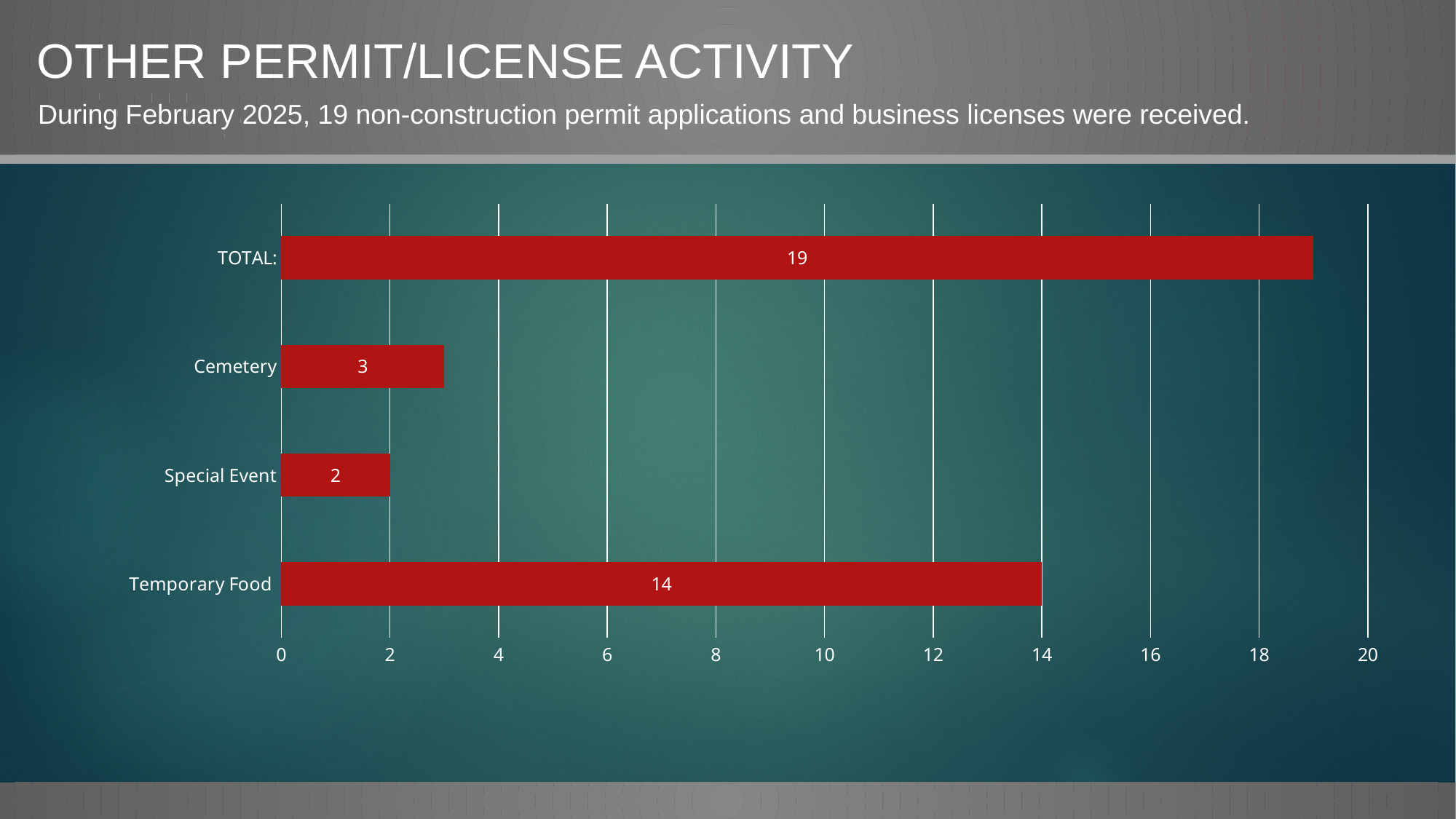
What is the difference between the values for Temporary Food and Cemetery? 11 What is the value for Cemetery? 3 Which category has the lowest value? Special Event What is the value for Temporary Food? 14 Is the value for Temporary Food greater or less than 10? greater What kind of chart is shown on the slide? bar chart What is the value shown for the TOTAL: bar? 19 Excluding the TOTAL: bar, which category has the highest value? Temporary Food What is the value for Special Event? 2 How many bars are plotted in the chart? 4 Which is larger, the value for Cemetery or the value for Special Event? Cemetery What is the title of the slide containing the chart? OTHER PERMIT/LICENSE ACTIVITY